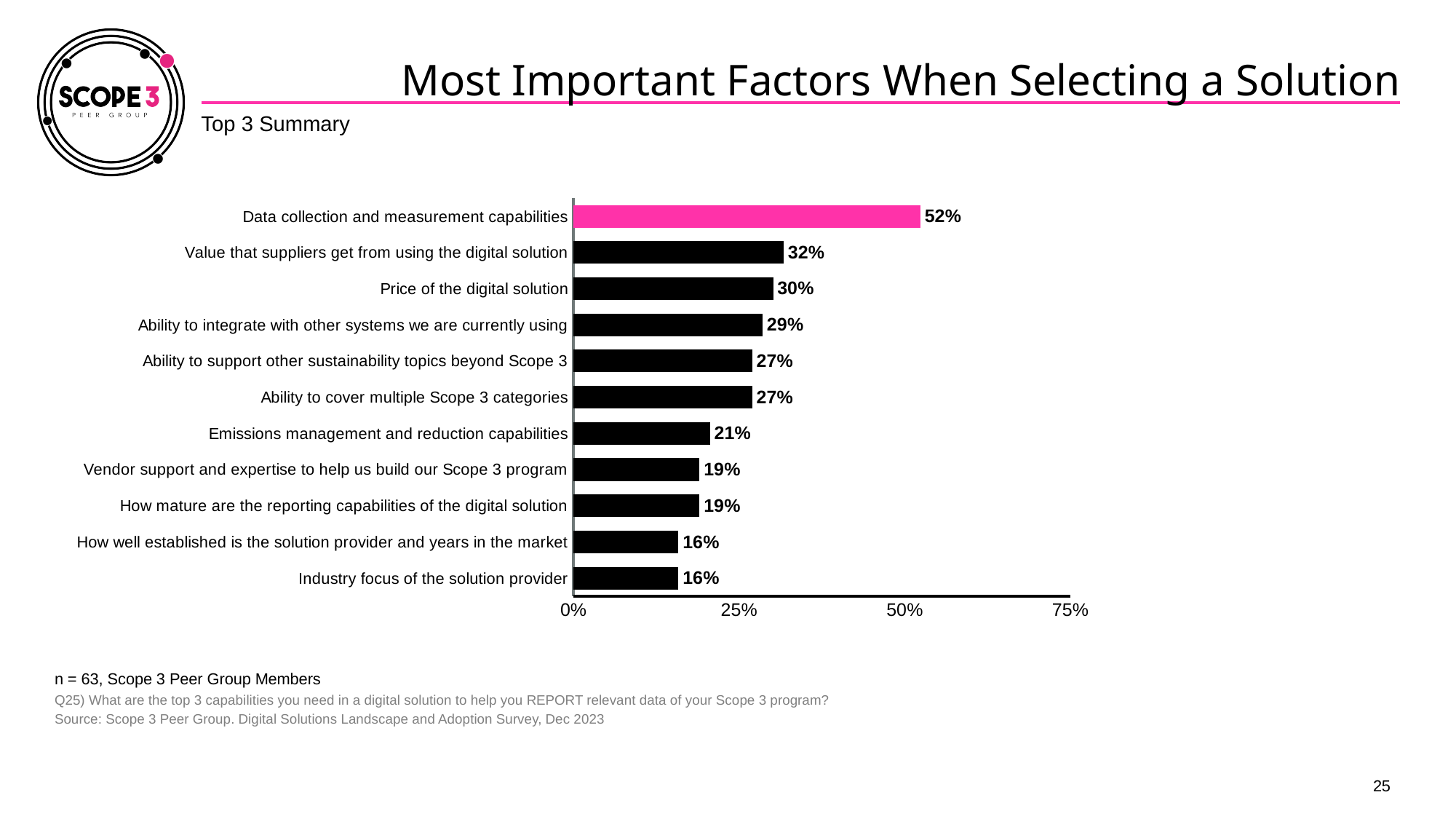
What is the value for 'Price of the digital solution'? 30% How many factors are listed on the chart? 11 What percentage is shown for 'Data collection and measurement capabilities'? 52% What is the difference between 'Data collection and measurement capabilities' and 'Value that suppliers get from using the digital solution'? 20 percentage points What type of chart is shown on the slide? Bar chart Which factor has the highest percentage? Data collection and measurement capabilities Which is larger: 'Ability to integrate with other systems we are currently using' or 'Emissions management and reduction capabilities'? Ability to integrate with other systems we are currently using Is the value for 'Data collection and measurement capabilities' greater or less than 50%? greater What percentage is shown for 'Emissions management and reduction capabilities'? 21% What is the title of the slide? Most Important Factors When Selecting a Solution What is the lowest percentage shown on the chart? 16% Which bar is coloured pink rather than black? Data collection and measurement capabilities